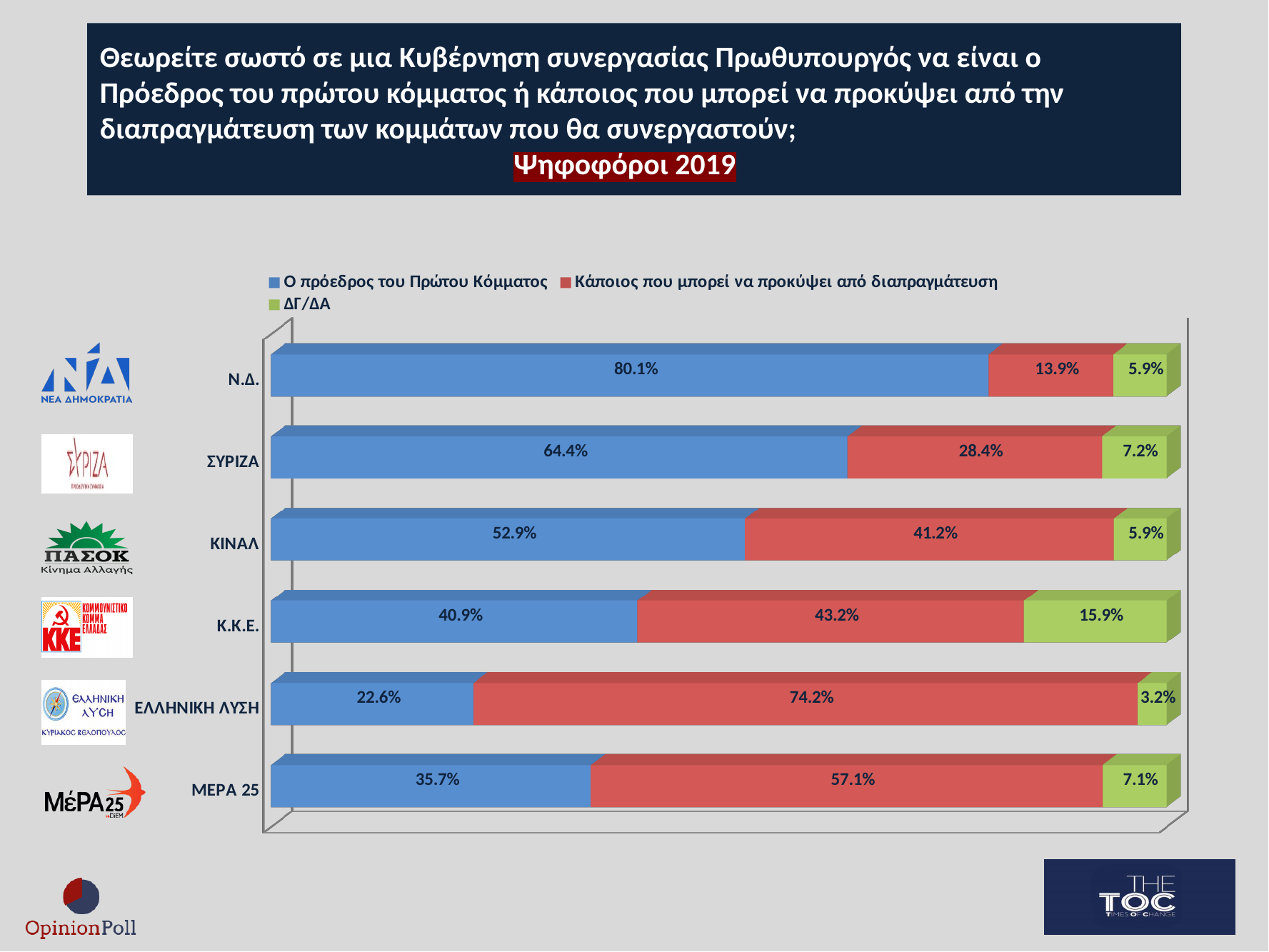
How many series does the legend list? 3 What is the ΔΓ/ΔΑ value for Κ.Κ.Ε. voters? 15.9% What kind of chart is shown on the slide? Stacked bar chart What is the difference between the 'Ο πρόεδρος του Πρώτου Κόμματος' values for Ν.Δ. and ΣΥΡΙΖΑ? 15.7 percentage points Which party has the lowest ΔΓ/ΔΑ value? ΕΛΛΗΝΙΚΗ ΛΥΣΗ Which party has the highest value for 'Ο πρόεδρος του Πρώτου Κόμματος'? Ν.Δ. Among ΜΕΡΑ 25 voters, which is larger: 'Ο πρόεδρος του Πρώτου Κόμματος' or 'Κάποιος που μπορεί να προκύψει από διαπραγμάτευση'? Κάποιος που μπορεί να προκύψει από διαπραγμάτευση What is the value for 'Ο πρόεδρος του Πρώτου Κόμματος' among Ν.Δ. voters? 80.1% What colour represents the ΔΓ/ΔΑ series in the chart? Green How many parties (categories) are shown in the chart? 6 Which party has the lowest value for 'Ο πρόεδρος του Πρώτου Κόμματος'? ΕΛΛΗΝΙΚΗ ΛΥΣΗ What is the value for 'Κάποιος που μπορεί να προκύψει από διαπραγμάτευση' among ΕΛΛΗΝΙΚΗ ΛΥΣΗ voters? 74.2%